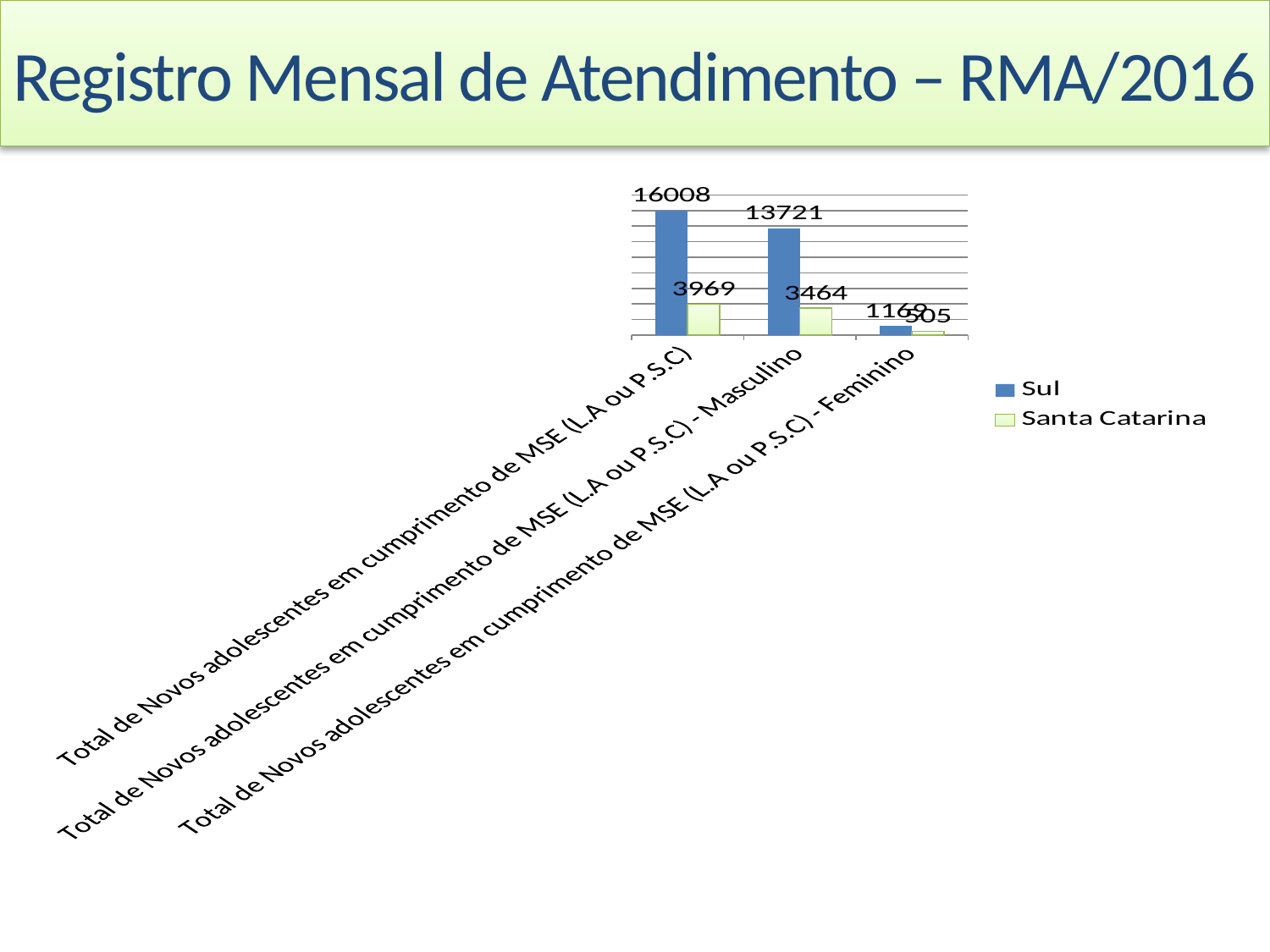
What type of chart is shown on the slide? Bar chart How many series does the legend list? 2 Which series is shown in blue in the legend? Sul What is the value for Sul in the 'Feminino' category? 1169 What is the value for Santa Catarina in the 'Masculino' category? 3464 Which category has the lowest value for Sul? Total de Novos adolescentes em cumprimento de MSE (L.A ou P.S.C) - Feminino How many categories are shown on the x axis? 3 What is the value for Santa Catarina in the category 'Total de Novos adolescentes em cumprimento de MSE (L.A ou P.S.C)'? 3969 What is the difference between the Sul values for the 'Total de Novos adolescentes em cumprimento de MSE (L.A ou P.S.C)' category and the 'Masculino' category? 2287 What is the value for Sul in the 'Masculino' category? 13721 What is the value for Sul in the category 'Total de Novos adolescentes em cumprimento de MSE (L.A ou P.S.C)'? 16008 In the 'Masculino' category, which series has the larger value, Sul or Santa Catarina? Sul